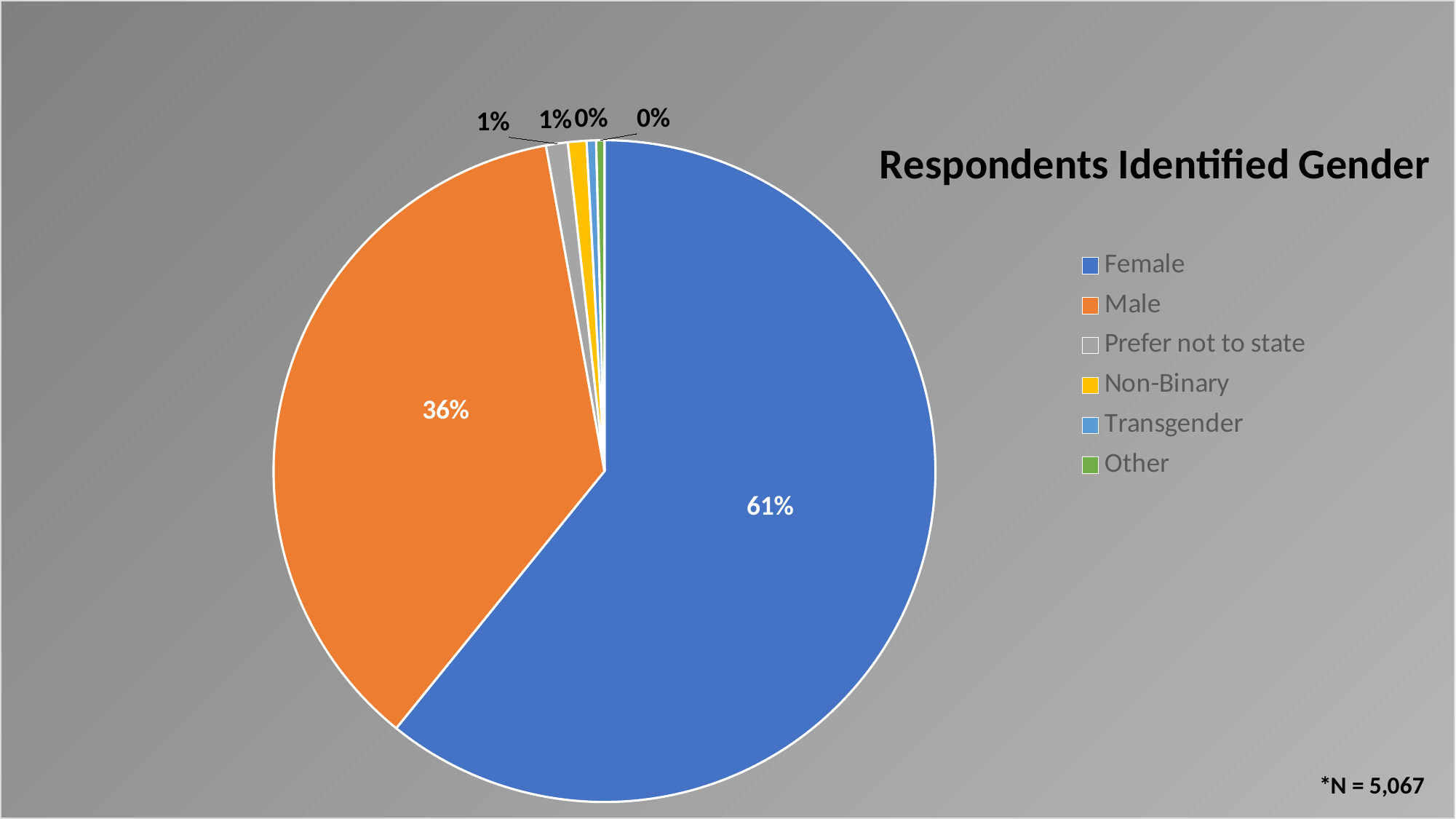
Which slice is larger, Female or Male? Female What is the value of N given in the note on the slide? 5,067 What is the difference in percentage points between the Female and Male slices? 25% What share of the pie does the Male slice represent? 36% How many categories does the legend list? 6 What percentage of respondents chose Prefer not to state? 1% What percentage of respondents identified as Non-Binary? 1% What percentage of respondents identified as Male? 36% What percentage of respondents identified as Female? 61% What kind of chart is shown on the slide? pie chart Which gender category has the largest share of the pie? Female What is the title of the chart? Respondents Identified Gender